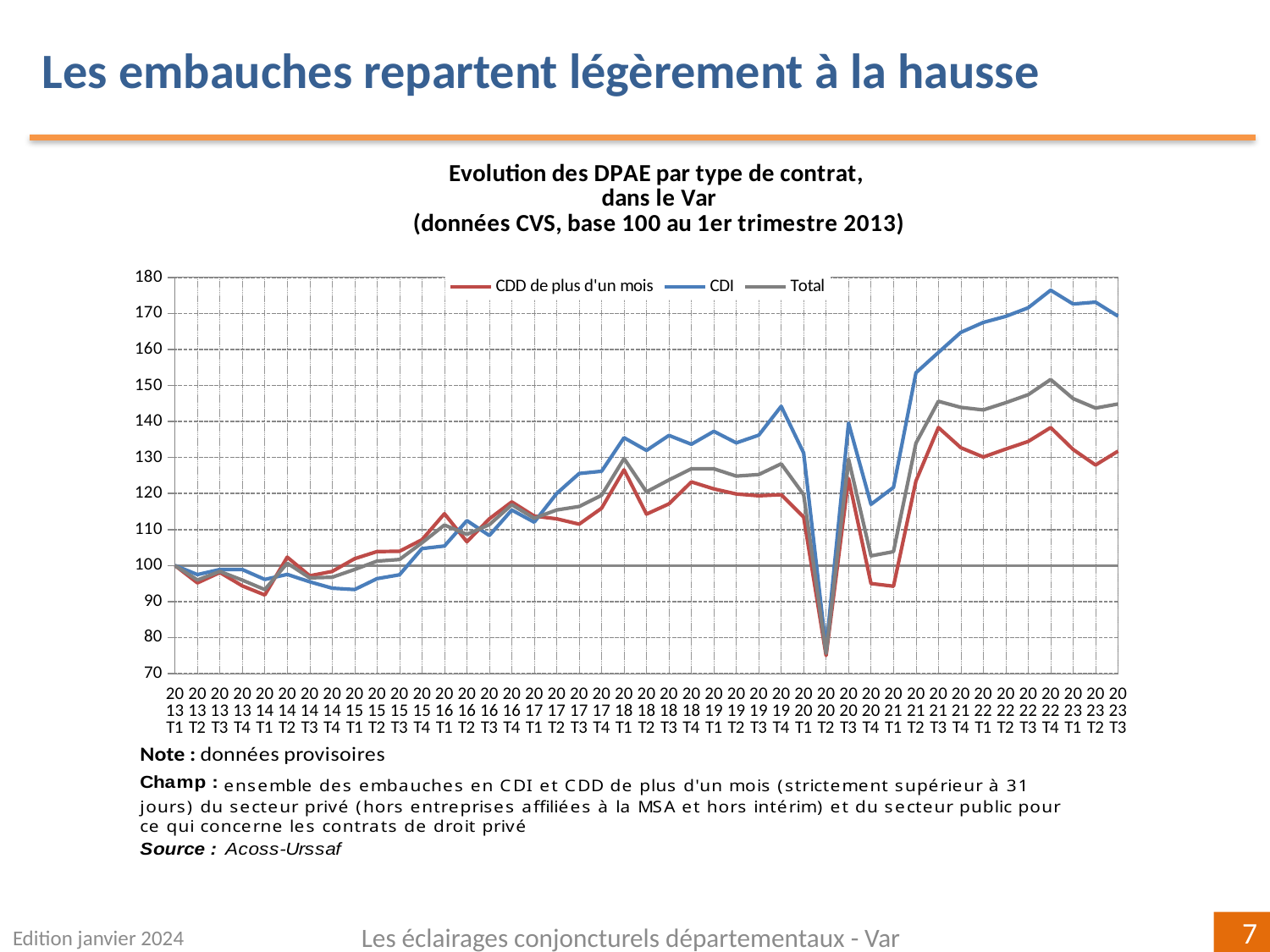
What colour is the CDI line? Blue Which series has the highest value at 2023 T3? CDI How many quarters are plotted along the x axis? 43 Does the CDI series rise or fall between 2021 T1 and 2022 T4? rise Is the value of CDI at 2023 T3 greater or less than 160? greater In which quarter does the CDI series reach its lowest value? 2020 T2 What kind of chart is shown on the slide? Line chart Is the value of CDD de plus d'un mois at 2021 T1 greater or less than 100? less Is the value of CDI at 2022 T4 greater or less than 170? greater Which series are listed in the legend? CDD de plus d'un mois, CDI, Total How many series does the legend list? 3